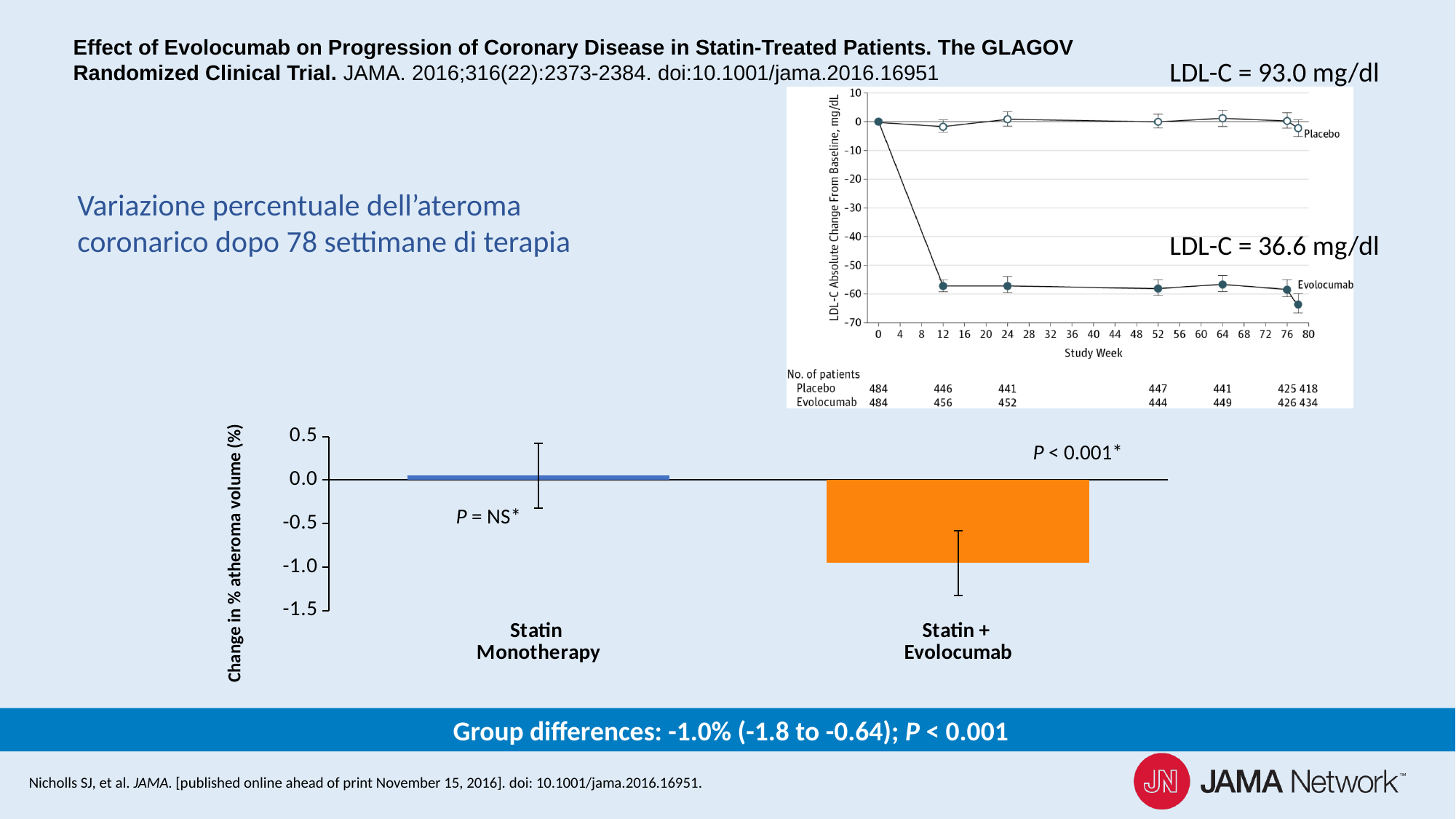
In the upper line chart, which series has the higher LDL-C absolute change from baseline at study week 52, Placebo or Evolocumab? Placebo In the lower bar chart, is the change in % atheroma volume for Statin Monotherapy greater or less than -0.5? greater What kind of chart is the lower chart showing change in % atheroma volume? bar chart In the upper line chart, what LDL-C level is annotated next to the Evolocumab line? LDL-C = 36.6 mg/dl In the lower bar chart, what P value is shown above the Statin + Evolocumab bar? P < 0.001* In the upper line chart, how many patients were in the Evolocumab group at study week 12? 456 What is the group difference in change in % atheroma volume reported in the blue banner? -1.0% (-1.8 to -0.64) In the upper line chart, is the LDL-C absolute change from baseline for Evolocumab at study week 12 greater or less than -50 mg/dL? less In the lower bar chart, how many treatment groups are shown? 2 In the lower bar chart, is the change in % atheroma volume for Statin + Evolocumab greater or less than -0.5? less In the lower bar chart, which group has the lower change in % atheroma volume? Statin + Evolocumab In the upper line chart of LDL-C absolute change from baseline, how many series are plotted? 2